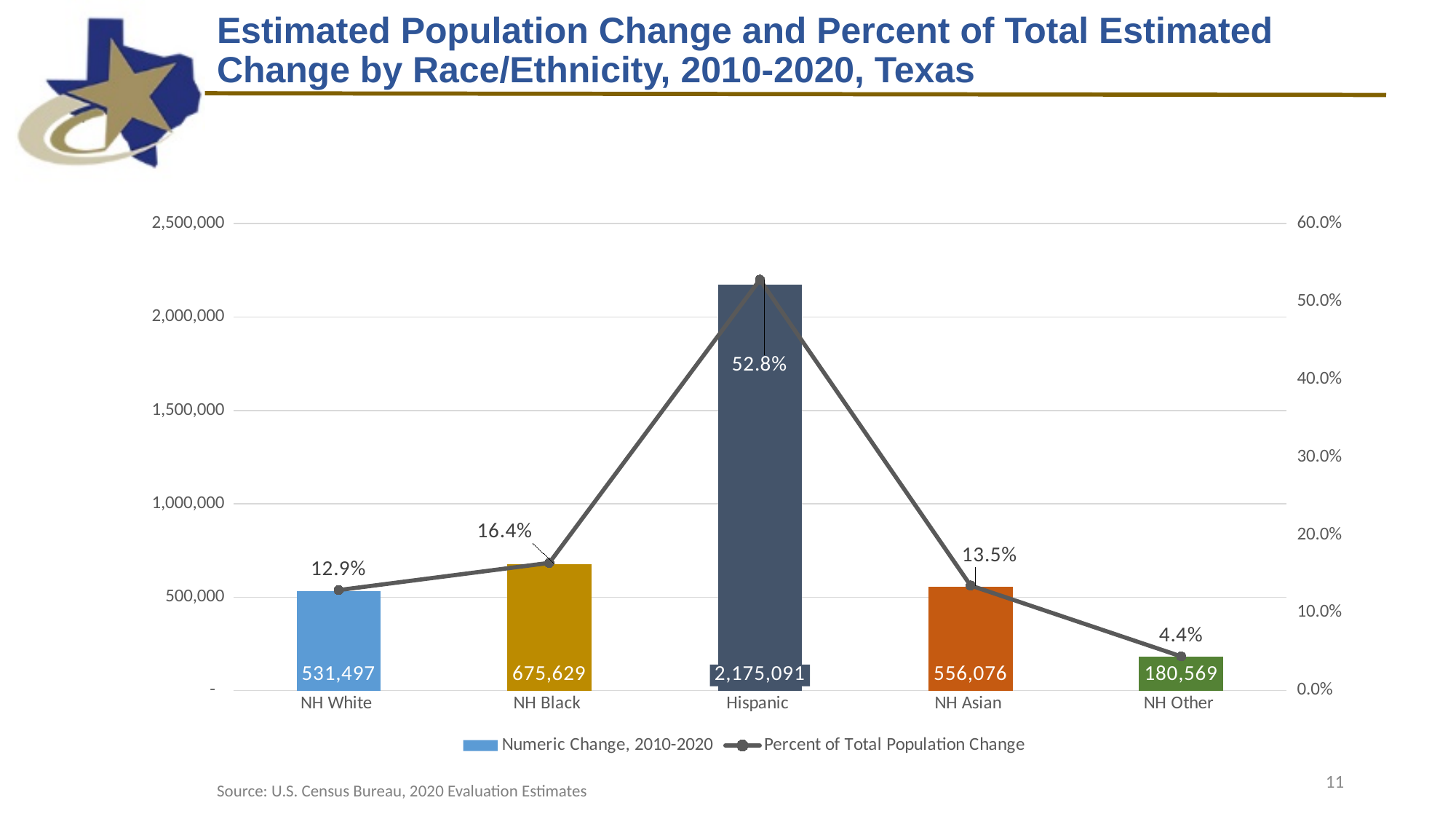
What is the numeric change, 2010-2020, for NH Other? 180,569 Which has a larger numeric change, 2010-2020: NH Asian or NH White? NH Asian How many race/ethnicity categories are shown on the x axis? 5 What is the numeric change, 2010-2020, for Hispanic? 2,175,091 Which race/ethnicity category has the lowest percent of total population change? NH Other What is the difference in numeric change, 2010-2020, between NH Black and NH White? 144,132 Is the numeric change, 2010-2020, for Hispanic greater or less than 2,000,000? greater What is the source cited below the chart? U.S. Census Bureau, 2020 Evaluation Estimates How many series does the legend list? 2 What kind of chart is used to show the numeric change, 2010-2020? Bar chart What is the percent of total population change for NH Black? 16.4% Which race/ethnicity category has the highest numeric change, 2010-2020? Hispanic